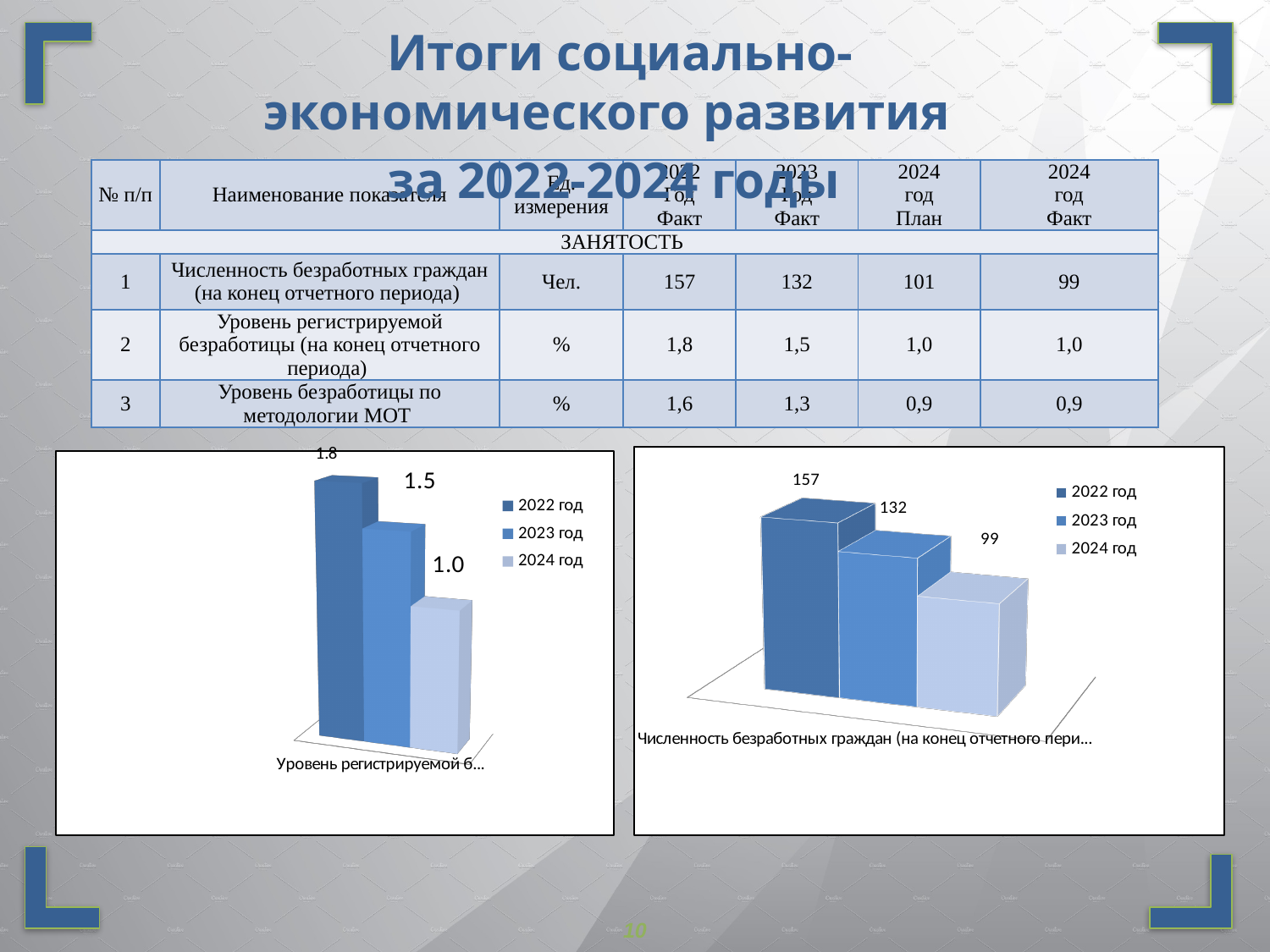
In the left chart, which year has the lowest value? 2024 год In the left chart, what is the value for 2024 год? 1.0 In the right chart, which is larger, the value for 2023 год or the value for 2024 год? 2023 год In the left chart, what is the difference between the values for 2022 год and 2023 год? 0.3 In the right chart, do the values rise or fall from 2022 год to 2024 год? fall In the right chart, what is the value for 2023 год? 132 In the right chart, what is the value for 2024 год? 99 What kind of chart is the left chart? bar chart How many series does the legend of the right chart list? 3 In the left chart, what is the value for 2022 год? 1.8 In the right chart, what is the difference between the values for 2022 год and 2024 год? 58 In the right chart, which year has the highest value? 2022 год